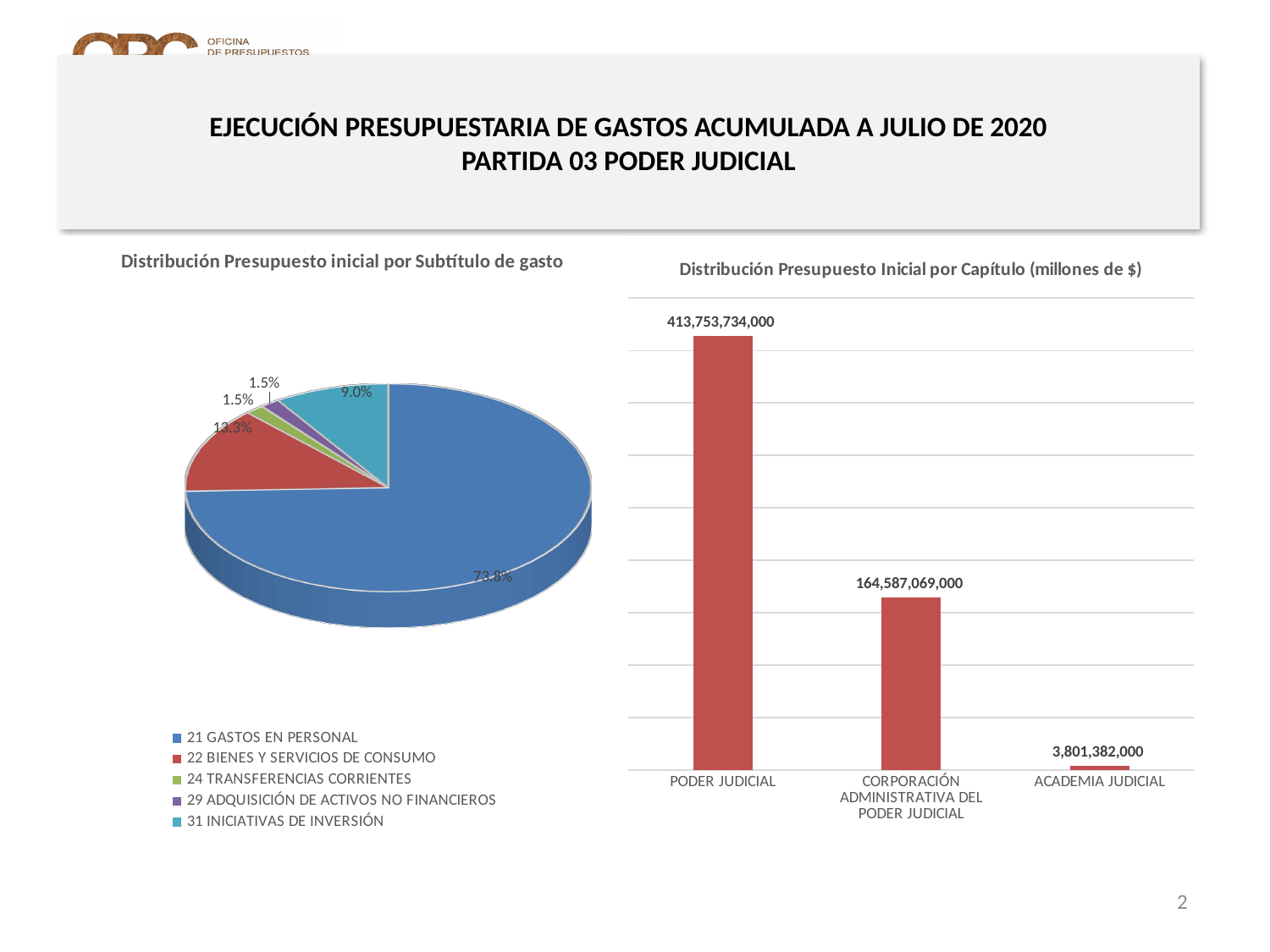
In the bar chart 'Distribución Presupuesto Inicial por Capítulo', which category has the highest value? PODER JUDICIAL In the bar chart 'Distribución Presupuesto Inicial por Capítulo', what is the value for PODER JUDICIAL? 413,753,734,000 In the pie chart 'Distribución Presupuesto inicial por Subtítulo de gasto', what share does 22 BIENES Y SERVICIOS DE CONSUMO have? 13.3% What type of chart is 'Distribución Presupuesto Inicial por Capítulo'? Bar chart In the bar chart 'Distribución Presupuesto Inicial por Capítulo', what is the difference between PODER JUDICIAL and CORPORACIÓN ADMINISTRATIVA DEL PODER JUDICIAL? 249,166,665,000 In the pie chart 'Distribución Presupuesto inicial por Subtítulo de gasto', what share does 31 INICIATIVAS DE INVERSIÓN have? 9.0% In the bar chart 'Distribución Presupuesto Inicial por Capítulo', what is the value for CORPORACIÓN ADMINISTRATIVA DEL PODER JUDICIAL? 164,587,069,000 In the bar chart 'Distribución Presupuesto Inicial por Capítulo', what is the value for ACADEMIA JUDICIAL? 3,801,382,000 How many entries does the legend of the pie chart 'Distribución Presupuesto inicial por Subtítulo de gasto' list? 5 In the bar chart 'Distribución Presupuesto Inicial por Capítulo', which category has the lowest value? ACADEMIA JUDICIAL In the pie chart 'Distribución Presupuesto inicial por Subtítulo de gasto', which category has the largest slice? 21 GASTOS EN PERSONAL How many categories are shown in the bar chart 'Distribución Presupuesto Inicial por Capítulo'? 3